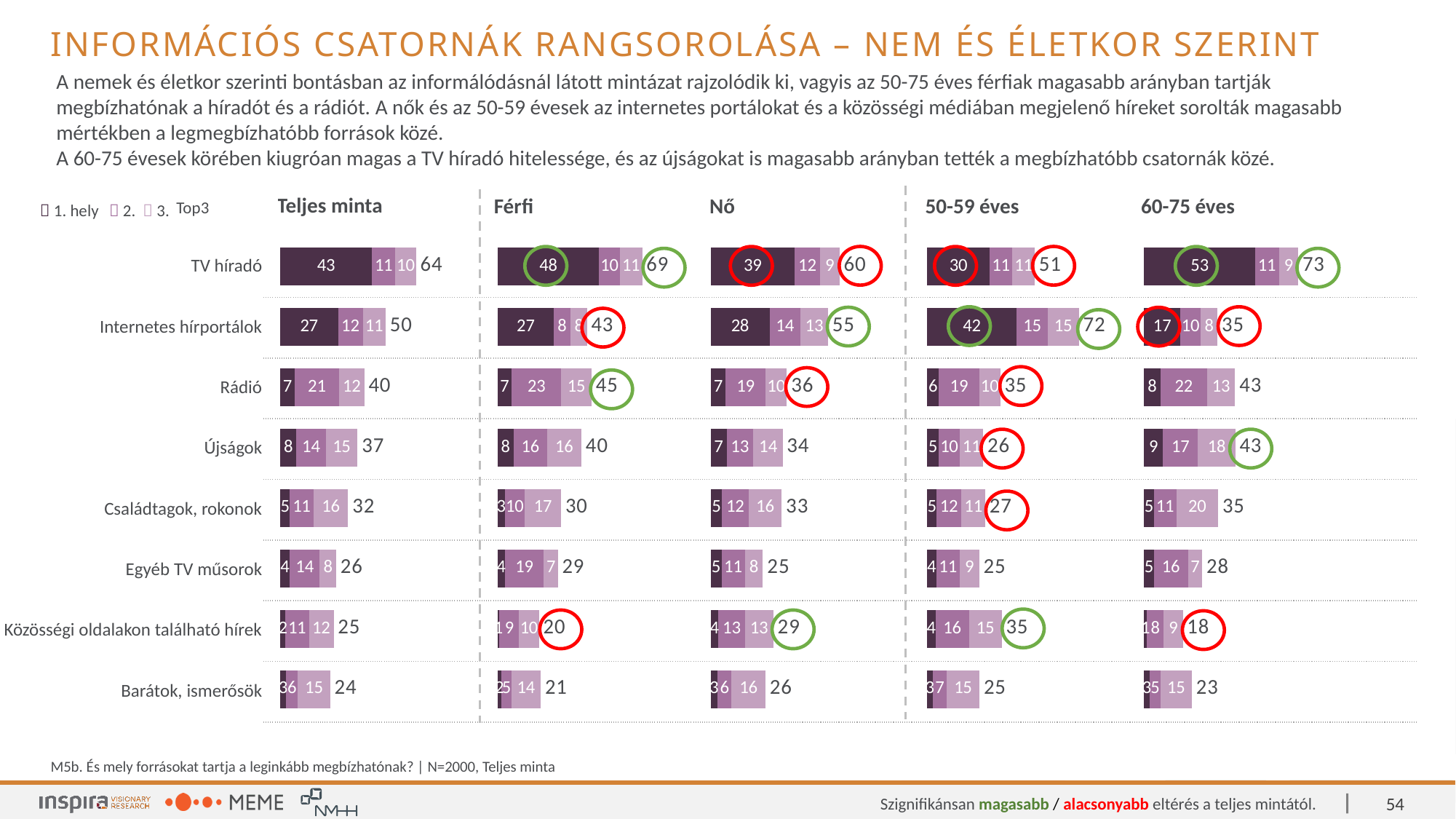
Which has the larger Top3 value for Internetes hírportálok: the 50-59 éves chart or the 60-75 éves chart? 50-59 éves In the 60-75 éves chart, which category has the highest Top3 value? TV híradó In the 50-59 éves chart, what is the Top3 value for Internetes hírportálok? 72 In the Teljes minta chart, what is the total of the stacked bar for Rádió (7 + 21 + 12)? 40 In the Teljes minta chart, what is the Top3 value for TV híradó? 64 In the Teljes minta chart, which category has the lowest Top3 value? Barátok, ismerősök How many categories (information channels) are shown in the Teljes minta chart? 8 In the Nő chart, what is the Top3 value for Rádió? 36 How many series does the legend list (excluding the Top3 label)? 3 What kind of chart is used for the Teljes minta data? Stacked bar chart In the Férfi chart, what is the 1. hely value for TV híradó? 48 What is the difference between the Top3 value for TV híradó in the Férfi chart and in the Nő chart? 9